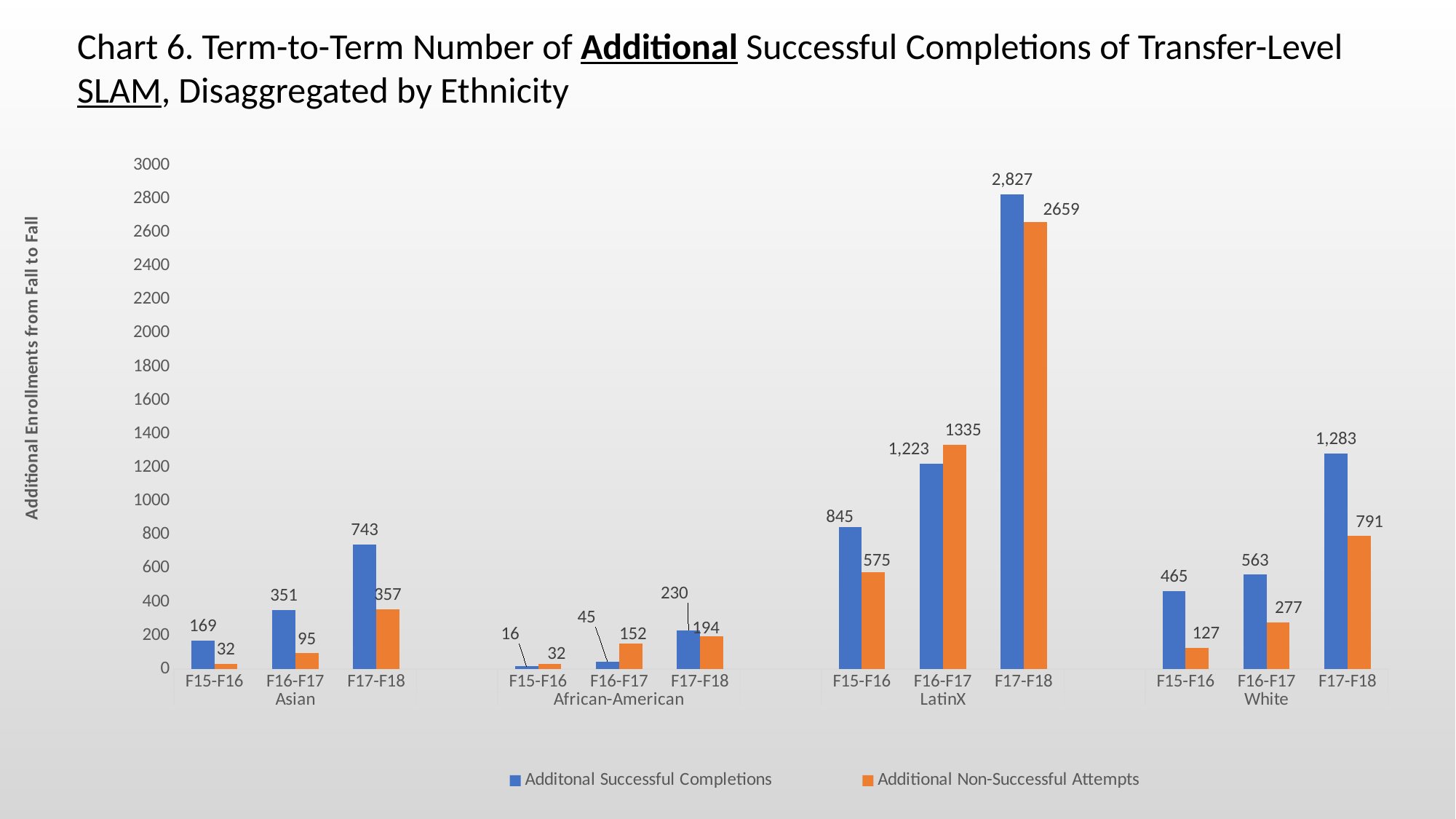
Do the Additional Successful Completions for White students rise or fall from F15-F16 to F17-F18? Rise What is the difference between Additional Successful Completions and Additional Non-Successful Attempts for Asian students in F17-F18? 386 For African-American students in F16-F17, which is larger: Additional Successful Completions or Additional Non-Successful Attempts? Additional Non-Successful Attempts What kind of chart is this? Bar chart What colour represents Additional Non-Successful Attempts? Orange Which ethnicity and term has the highest number of Additional Successful Completions? LatinX, F17-F18 What is the number of Additional Successful Completions for LatinX students in F17-F18? 2,827 How many series does the legend list? 2 What is the number of Additional Non-Successful Attempts for White students in F16-F17? 277 What is the number of Additional Successful Completions for Asian students in F15-F16? 169 Which ethnicity and term has the lowest number of Additional Successful Completions? African-American, F15-F16 How many ethnicity groups are shown on the x axis? 4